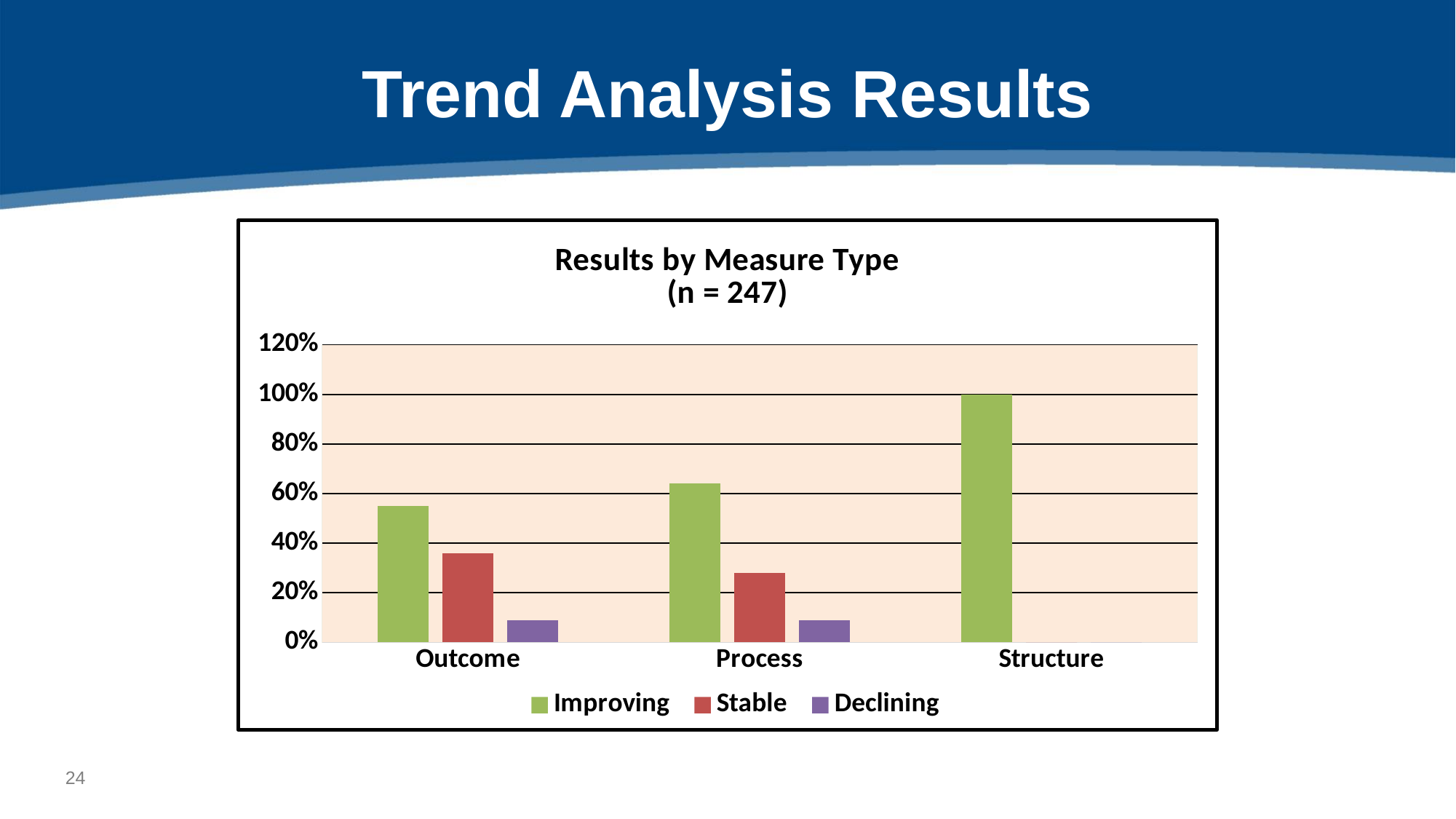
What is the Improving value for Structure? 100% How many series does the legend list? 3 Which is larger, the Stable value for Outcome or the Stable value for Process? Outcome How many measure type categories are shown on the x axis? 3 Is the Improving value for Outcome greater or less than 60%? less Is the Stable value for Process greater or less than 20%? greater Which is larger, the Improving value for Process or the Improving value for Outcome? Process What is the title of the chart? Results by Measure Type (n = 247) What type of chart is shown on the slide? Bar chart Which category has the highest Improving bar? Structure Is the Declining value for Process greater or less than 20%? less